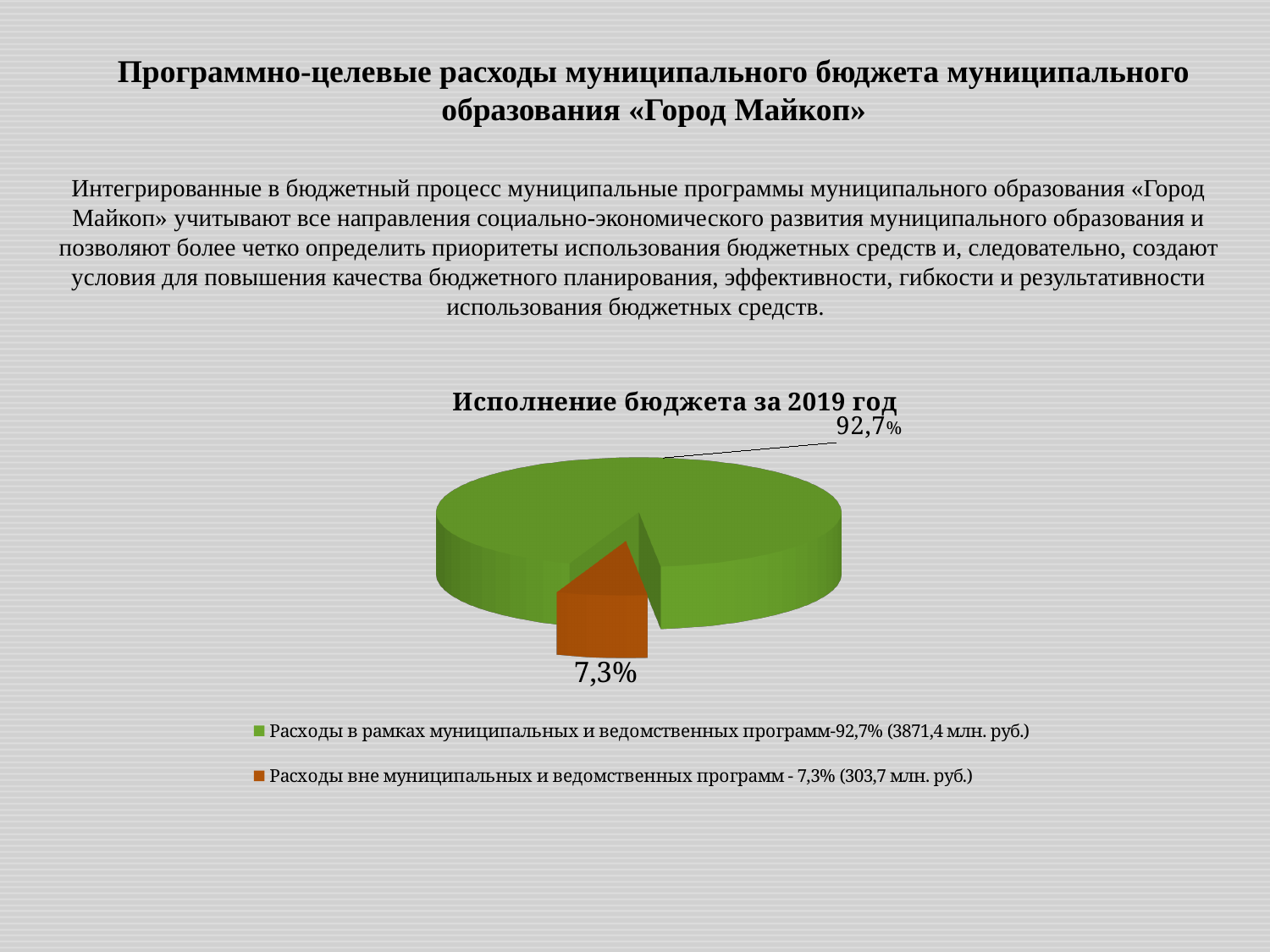
What is the title of the chart? Исполнение бюджета за 2019 год Which slice is the largest in the pie chart? Расходы в рамках муниципальных и ведомственных программ What is the difference in percentage points between the two slices of the pie chart? 85,4 What share of the pie is labelled for expenses outside municipal and departmental programmes (Расходы вне муниципальных и ведомственных программ)? 7,3% According to the legend, what amount in million rubles corresponds to expenses within municipal and departmental programmes? 3871,4 млн. руб. What colour is the slice for expenses outside municipal and departmental programmes? Orange How many slices does the pie chart have? 2 What share of the pie is labelled for expenses within municipal and departmental programmes (Расходы в рамках муниципальных и ведомственных программ)? 92,7% Which slice is the smallest in the pie chart? Расходы вне муниципальных и ведомственных программ What kind of chart is shown on the slide? Pie chart How many entries does the legend list? 2 Which is larger: the share of expenses within programmes or the share of expenses outside programmes? Expenses within programmes (92,7%)